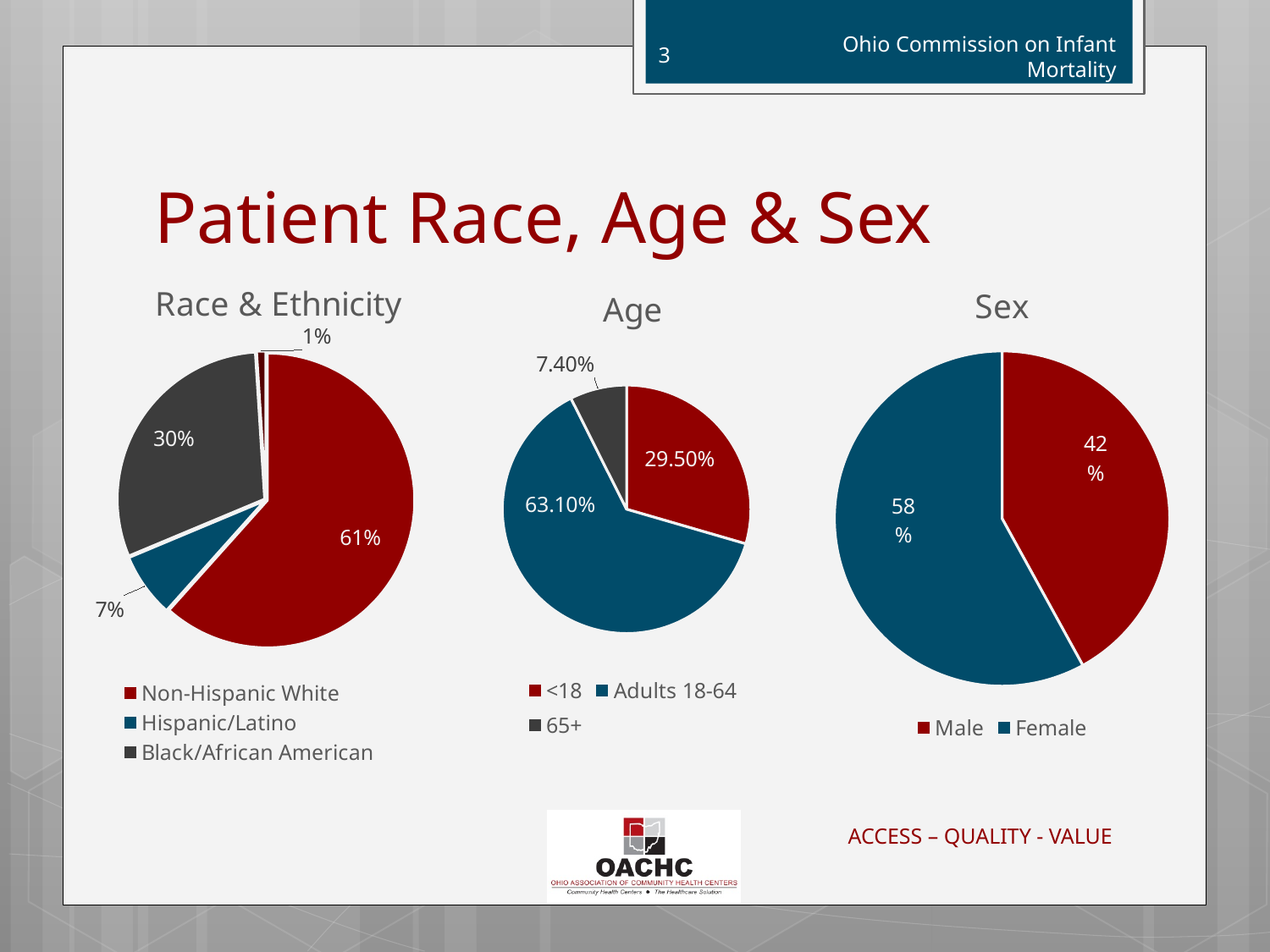
In the Race & Ethnicity pie chart, what percentage is Non-Hispanic White? 61% In the Sex pie chart, what percentage is Female? 58% In the Age pie chart, which age group has the smallest share? 65+ In the Age pie chart, what percentage is Adults 18-64? 63.10% In the Age pie chart, what percentage is <18? 29.50% What type of chart is used for the Sex chart? Pie chart How many categories does the Age pie chart show? 3 In the Race & Ethnicity pie chart, what percentage is Hispanic/Latino? 7% In the Sex pie chart, which is larger, Male or Female? Female In the Race & Ethnicity pie chart, what percentage is Black/African American? 30% In the Race & Ethnicity pie chart, what is the difference between the Non-Hispanic White and Black/African American shares? 31% In the Race & Ethnicity pie chart, which category has the largest share? Non-Hispanic White